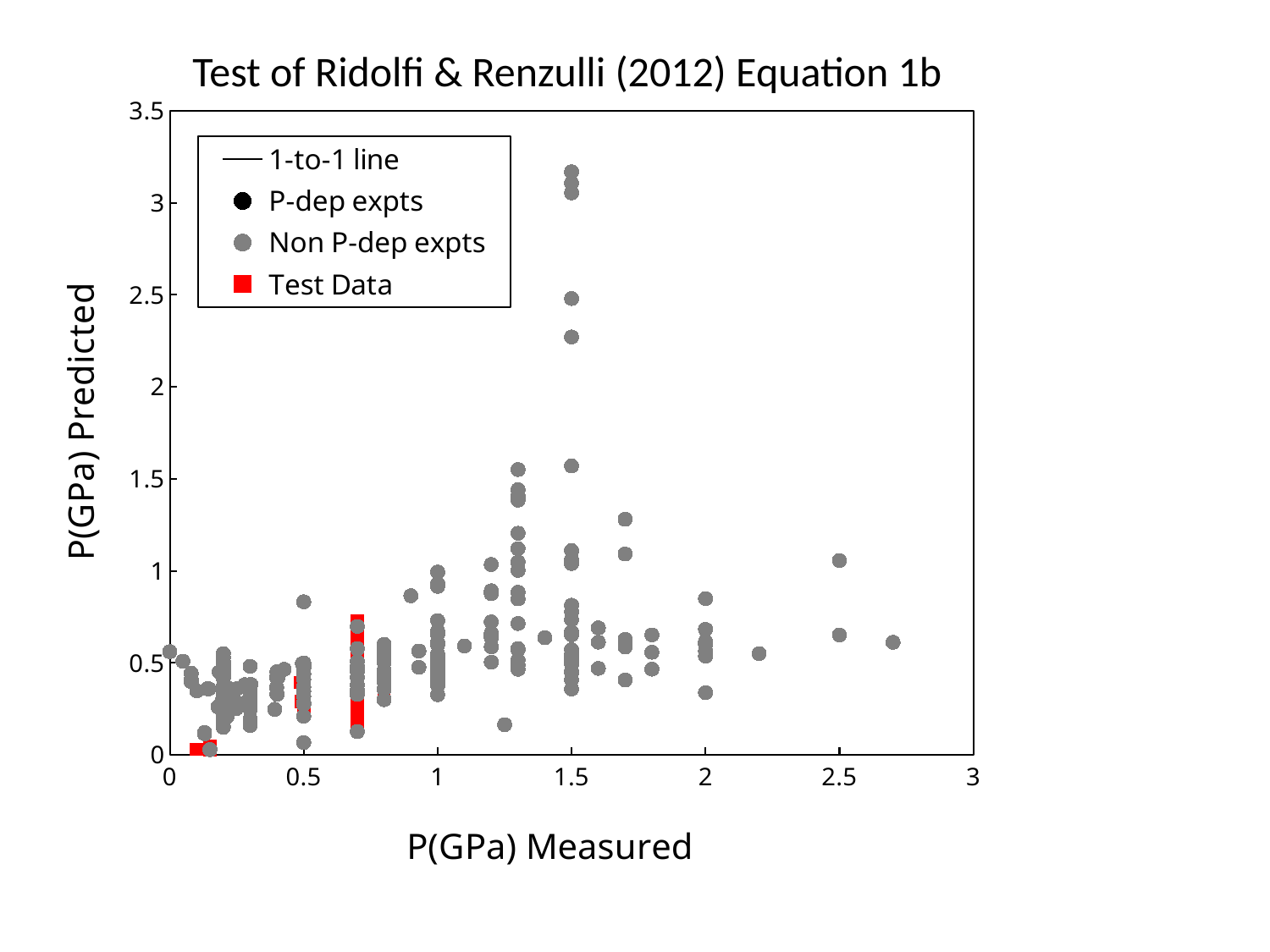
What is the title of the chart? Test of Ridolfi & Renzulli (2012) Equation 1b Is the predicted value for the point at a measured pressure of 2.7 greater or less than 1? less Is the highest predicted value plotted at a measured pressure of 1.5 greater or less than 3? greater Is the predicted value for the point at a measured pressure of 2.2 greater or less than 1? less At which measured pressure (x value) does the highest predicted value occur? 1.5 What kind of chart is shown on the slide? scatter plot How many entries does the chart's legend list? 4 Which has the larger maximum predicted value: the points at measured pressure 1.5 or the points at measured pressure 2.0? 1.5 Which legend series is plotted with red squares? Test Data